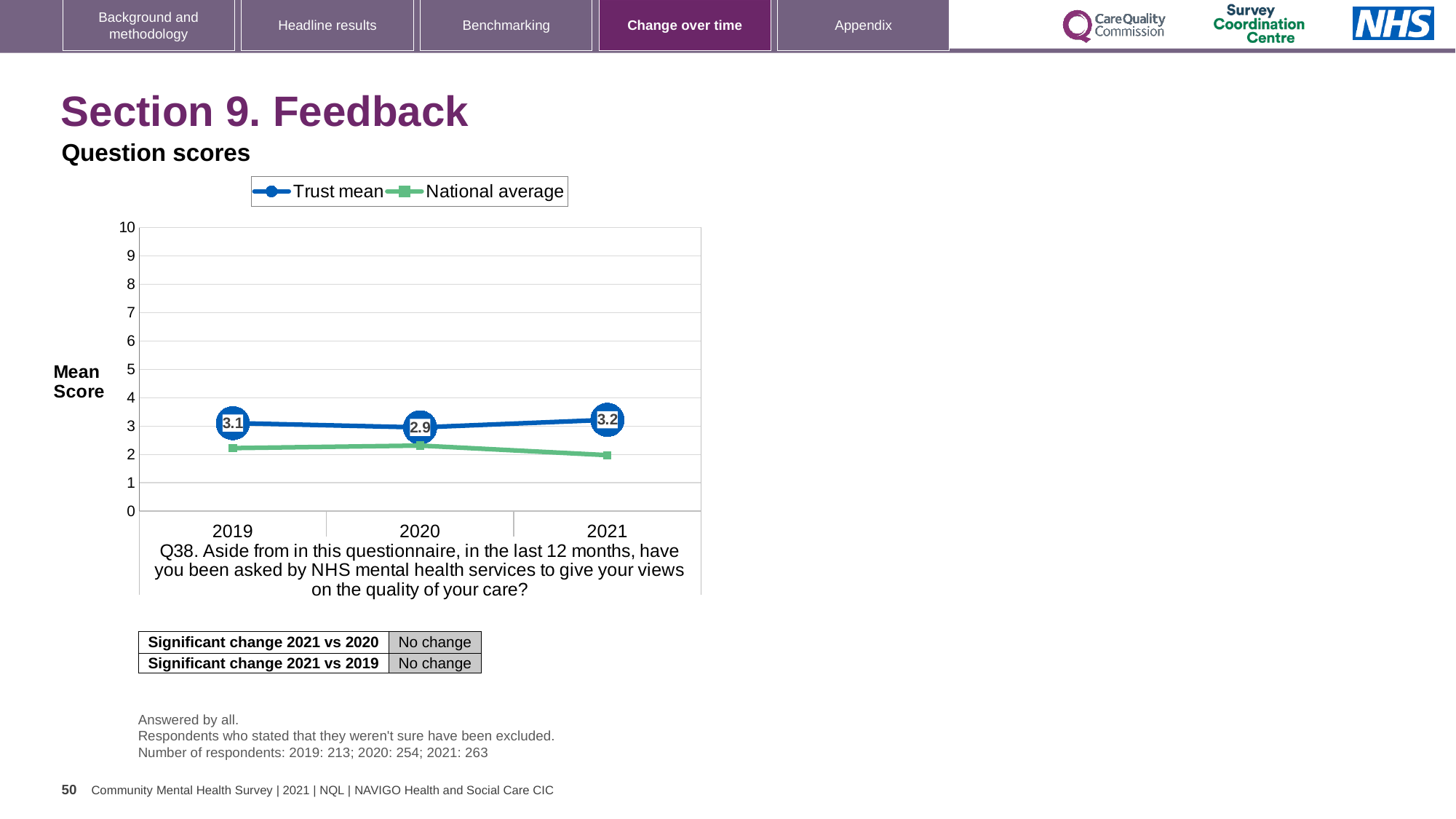
What kind of chart is shown? line chart How many series does the legend list? 2 In which year is the Trust mean highest? 2021 How many years are shown on the x axis? 3 What is the label on the y axis? Mean Score What is the Trust mean score for 2020? 2.9 Which is larger in 2021, the Trust mean or the National average? Trust mean What is the Trust mean score for 2019? 3.1 In which year is the Trust mean lowest? 2020 What is the difference between the Trust mean in 2021 and in 2020? 0.3 What is the Trust mean score for 2021? 3.2 Is the National average for 2021 greater or less than 3? less